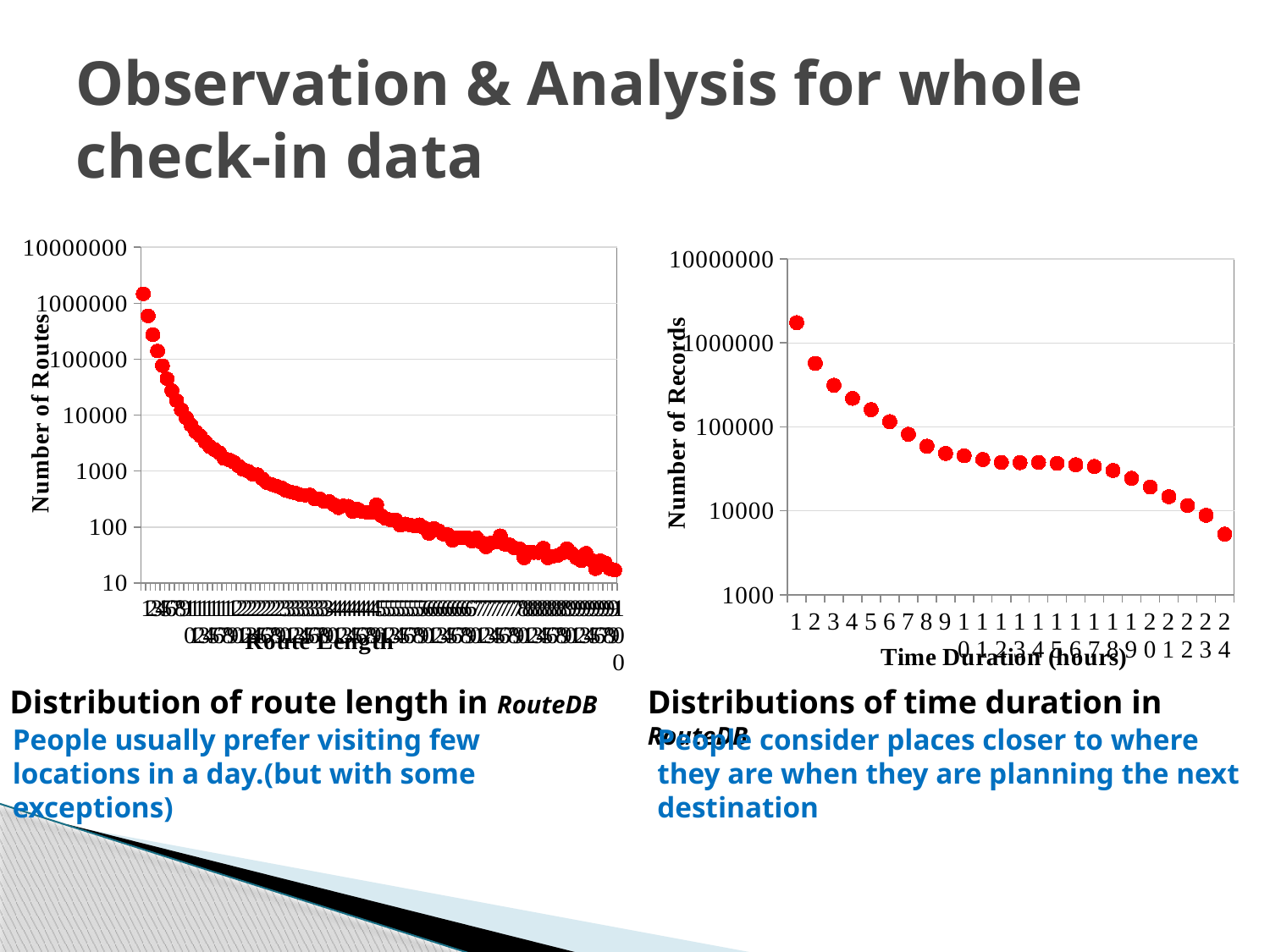
In the left chart, 'Distribution of route length in RouteDB', is the number of routes for the shortest route length greater or less than 1000000? greater In the right chart, 'Distributions of time duration in RouteDB', is the number of records at 24 hours greater or less than 10000? less In the right chart, 'Distributions of time duration in RouteDB', is the number of records at 1 hour greater or less than 1000000? greater In the right chart, 'Distributions of time duration in RouteDB', do the values rise or fall as time duration increases? fall In the right chart, 'Distributions of time duration in RouteDB', which has more records: 2 hours or 10 hours? 2 hours In the right chart, 'Distributions of time duration in RouteDB', which time duration has the highest number of records? 1 hour What is the y-axis title of the left chart, 'Distribution of route length in RouteDB'? Number of Routes What kind of chart is the left chart, 'Distribution of route length in RouteDB'? scatter chart What kind of chart is the right chart, 'Distributions of time duration in RouteDB'? scatter chart In the right chart, 'Distributions of time duration in RouteDB', which time duration has the lowest number of records? 24 hours In the left chart, 'Distribution of route length in RouteDB', do the values rise or fall as route length increases? fall What is the x-axis title of the right chart, 'Distributions of time duration in RouteDB'? Time Duration (hours)